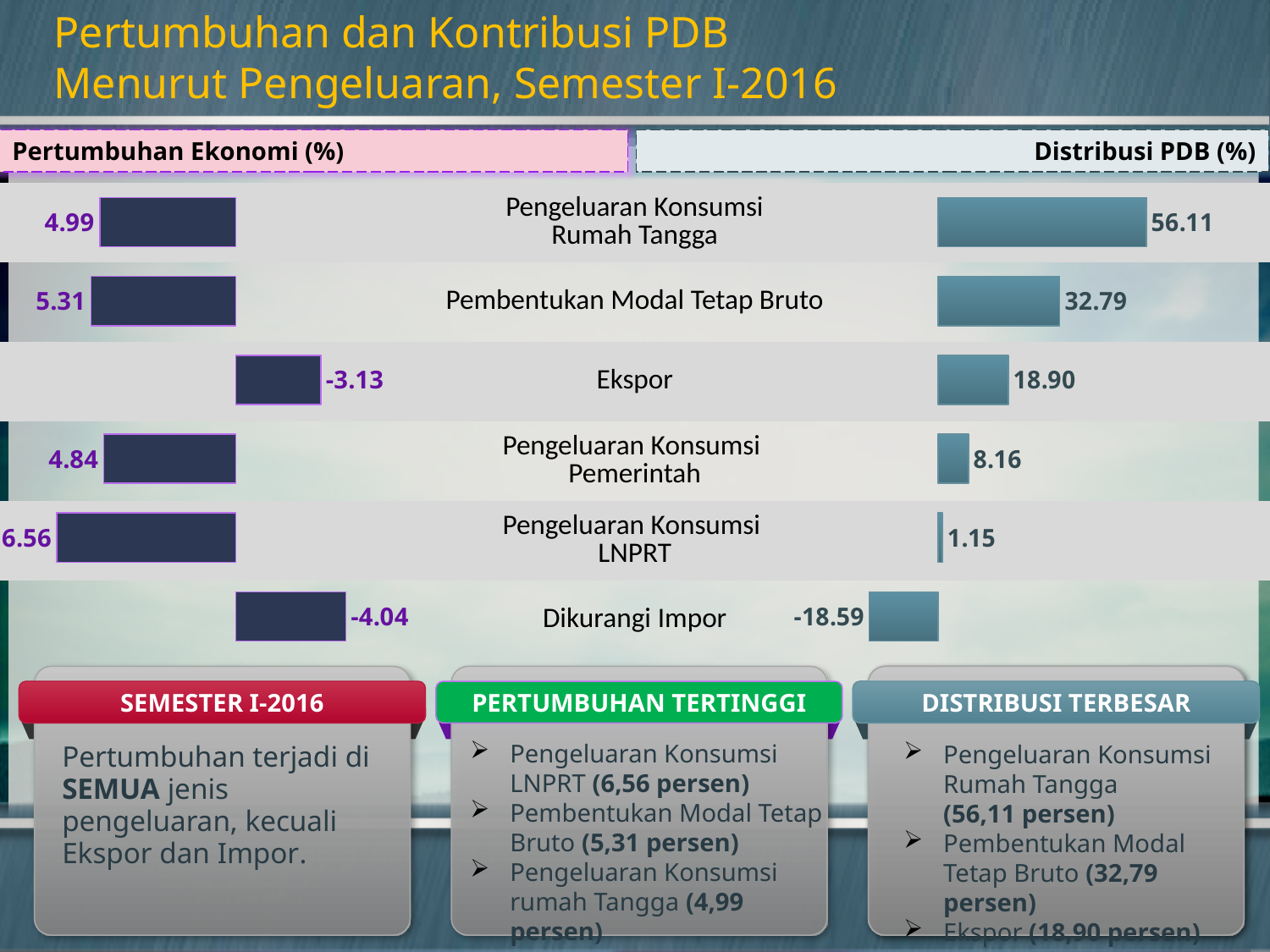
What type of chart is the Pertumbuhan Ekonomi (%) chart? Bar chart In the Distribusi PDB (%) chart, what is the value for Pengeluaran Konsumsi Rumah Tangga? 56.11 In the Distribusi PDB (%) chart, which category has the largest value? Pengeluaran Konsumsi Rumah Tangga How many categories are shown in the Distribusi PDB (%) chart? 6 In the Distribusi PDB (%) chart, what is the difference between Pengeluaran Konsumsi Rumah Tangga and Pembentukan Modal Tetap Bruto? 23.32 In the Pertumbuhan Ekonomi (%) chart, what is the difference between Pengeluaran Konsumsi LNPRT and Pengeluaran Konsumsi Rumah Tangga? 1.57 In the Pertumbuhan Ekonomi (%) chart, what is the value for Pengeluaran Konsumsi LNPRT? 6.56 In the Distribusi PDB (%) chart, what is the value for Dikurangi Impor? -18.59 In the Pertumbuhan Ekonomi (%) chart, which category has the lowest value? Dikurangi Impor In the Pertumbuhan Ekonomi (%) chart, which category has the highest value? Pengeluaran Konsumsi LNPRT In the Pertumbuhan Ekonomi (%) chart, what is the value for Ekspor? -3.13 In the Pertumbuhan Ekonomi (%) chart, which is larger: Pembentukan Modal Tetap Bruto or Pengeluaran Konsumsi Pemerintah? Pembentukan Modal Tetap Bruto